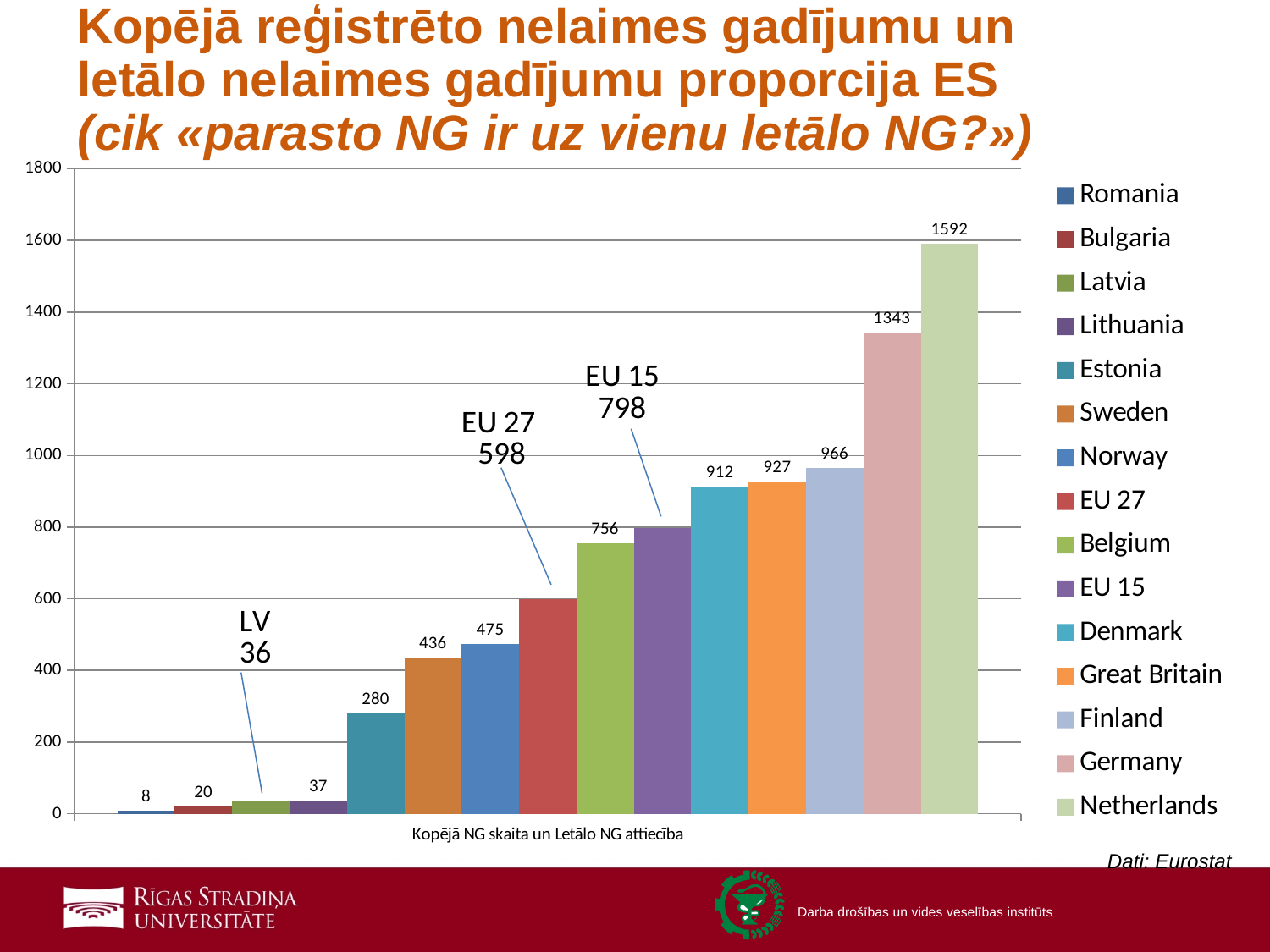
Which country has the lowest value in the chart? Romania Which is larger, the value for Finland or the value for Great Britain? Finland What is the difference between the values for Netherlands and Germany? 249 What is the value for Germany? 1343 What is the value for Estonia? 280 What is the value for Netherlands? 1592 Do the bar values rise or fall from left to right along the x axis? Rise How many series does the legend list? 15 What value is annotated for EU 27? 598 What value is annotated for EU 15? 798 Which country has the highest value in the chart? Netherlands What kind of chart is shown on the slide? Bar chart